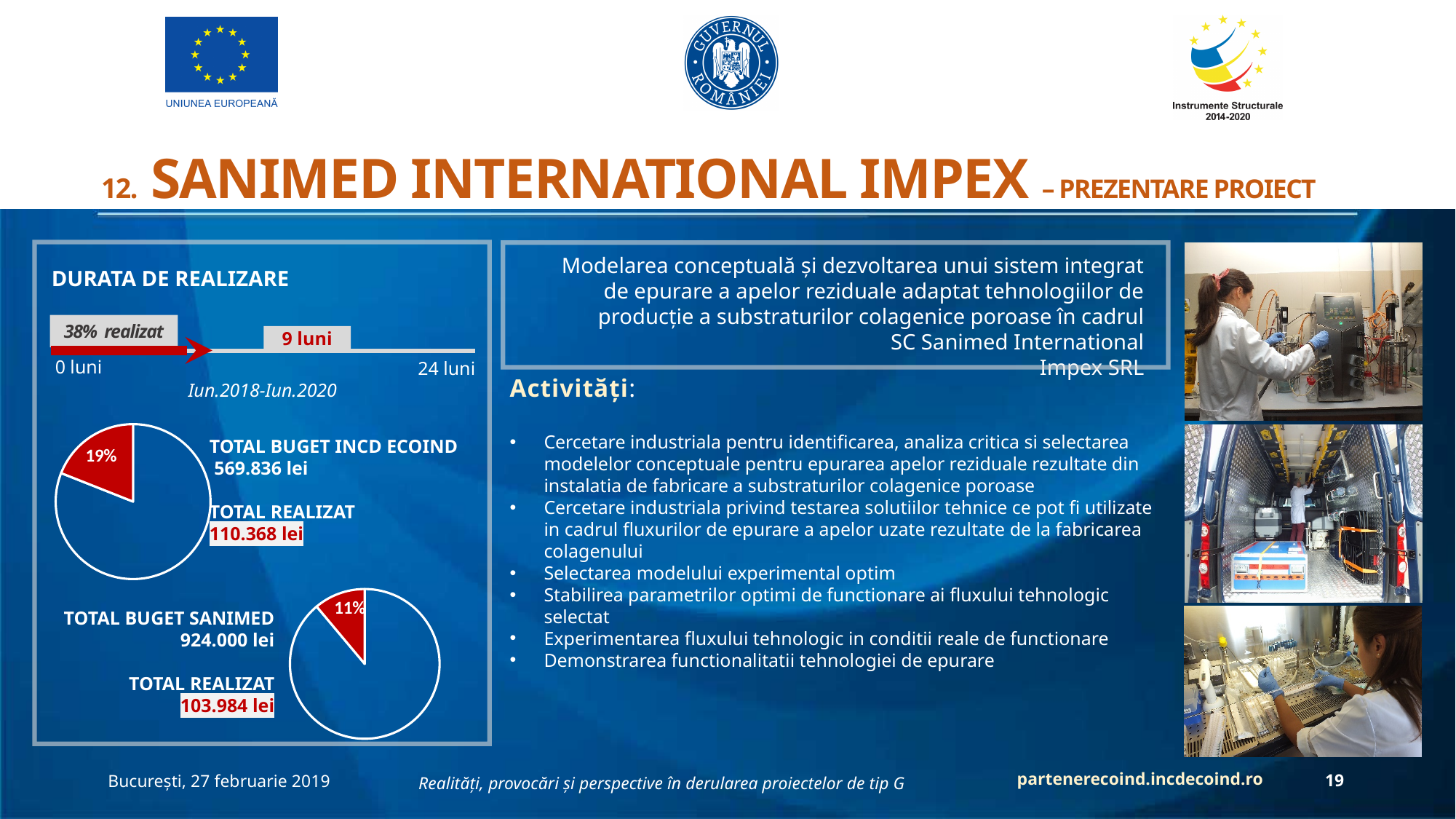
In the DURATA DE REALIZARE progress bar, what percentage is labelled as realized? 38% realizat What is the TOTAL BUGET SANIMED value shown next to the lower pie chart? 924.000 lei What is the difference in percentage points between the realized share in the upper pie chart (19%) and the lower pie chart (11%)? 8 percentage points In the upper pie chart (TOTAL BUGET INCD ECOIND), what percentage is shown on the red slice? 19% In the DURATA DE REALIZARE progress bar, how many months have elapsed out of the total shown? 9 luni out of 24 luni What is the TOTAL REALIZAT value shown next to the upper pie chart (INCD ECOIND)? 110.368 lei What is the TOTAL REALIZAT value shown next to the lower pie chart (SANIMED)? 103.984 lei Which pie chart shows a larger realized share: the upper one (INCD ECOIND) or the lower one (SANIMED)? the upper one (INCD ECOIND) What is the TOTAL BUGET INCD ECOIND value shown next to the upper pie chart? 569.836 lei In the lower pie chart (TOTAL BUGET SANIMED), what percentage is shown on the red slice? 11% What kind of chart is used to show the share of the INCD ECOIND budget that has been realized? pie chart How many pie charts are shown on the slide? 2